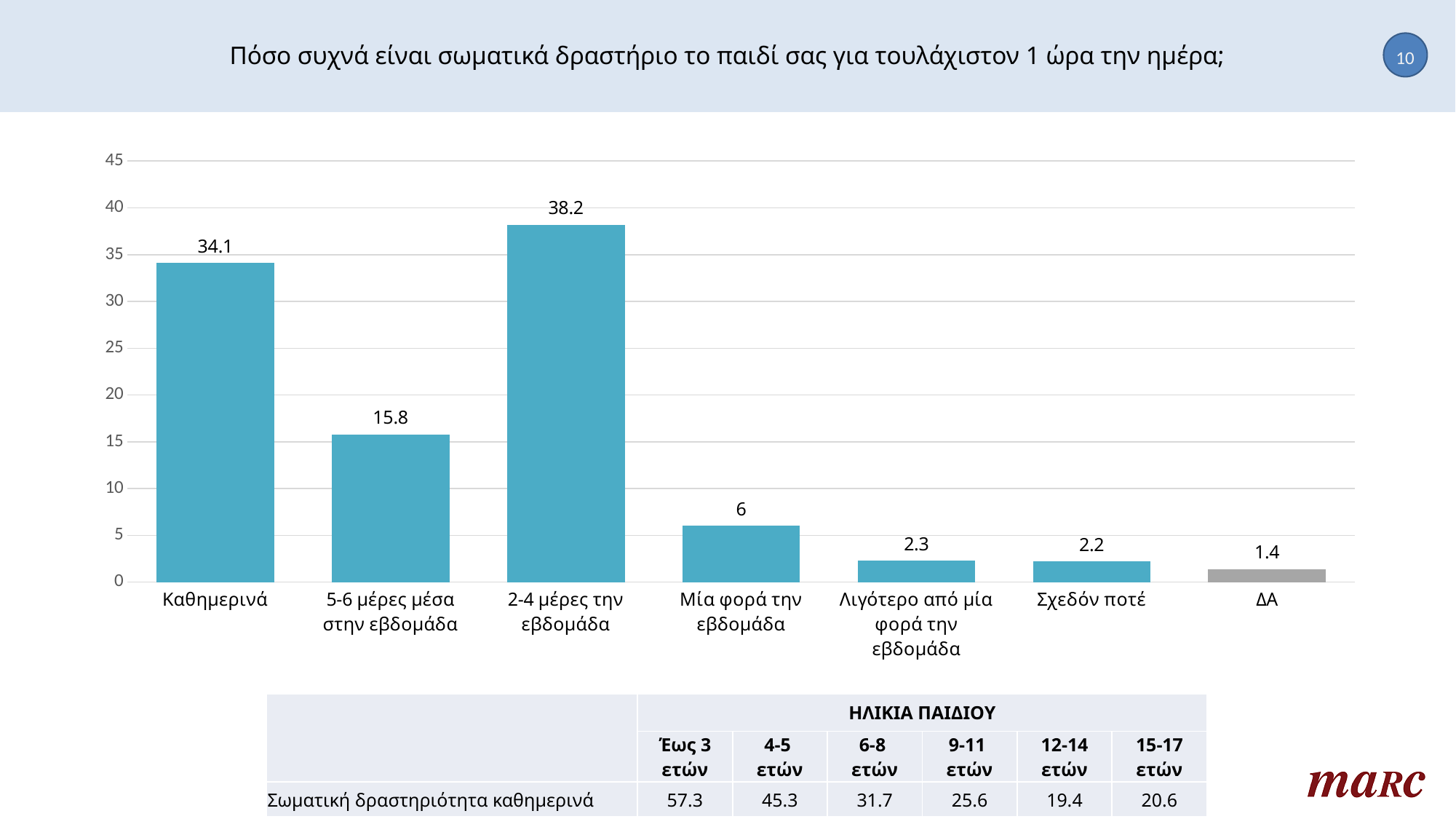
What is the value for Σχεδόν ποτέ? 2.2 How many categories are shown on the x axis of the chart? 7 What is the value for Καθημερινά? 34.1 What kind of chart is shown on the slide? bar chart Which is larger, the value for 5-6 μέρες μέσα στην εβδομάδα or the value for Μία φορά την εβδομάδα? 5-6 μέρες μέσα στην εβδομάδα What is the value for 2-4 μέρες την εβδομάδα? 38.2 What is the value for ΔΑ? 1.4 Which category has the highest value? 2-4 μέρες την εβδομάδα Which category has the lowest value? ΔΑ What is the difference between the values for 2-4 μέρες την εβδομάδα and Καθημερινά? 4.1 Is the value for Καθημερινά greater or less than 30? greater What colour is the bar for ΔΑ? grey